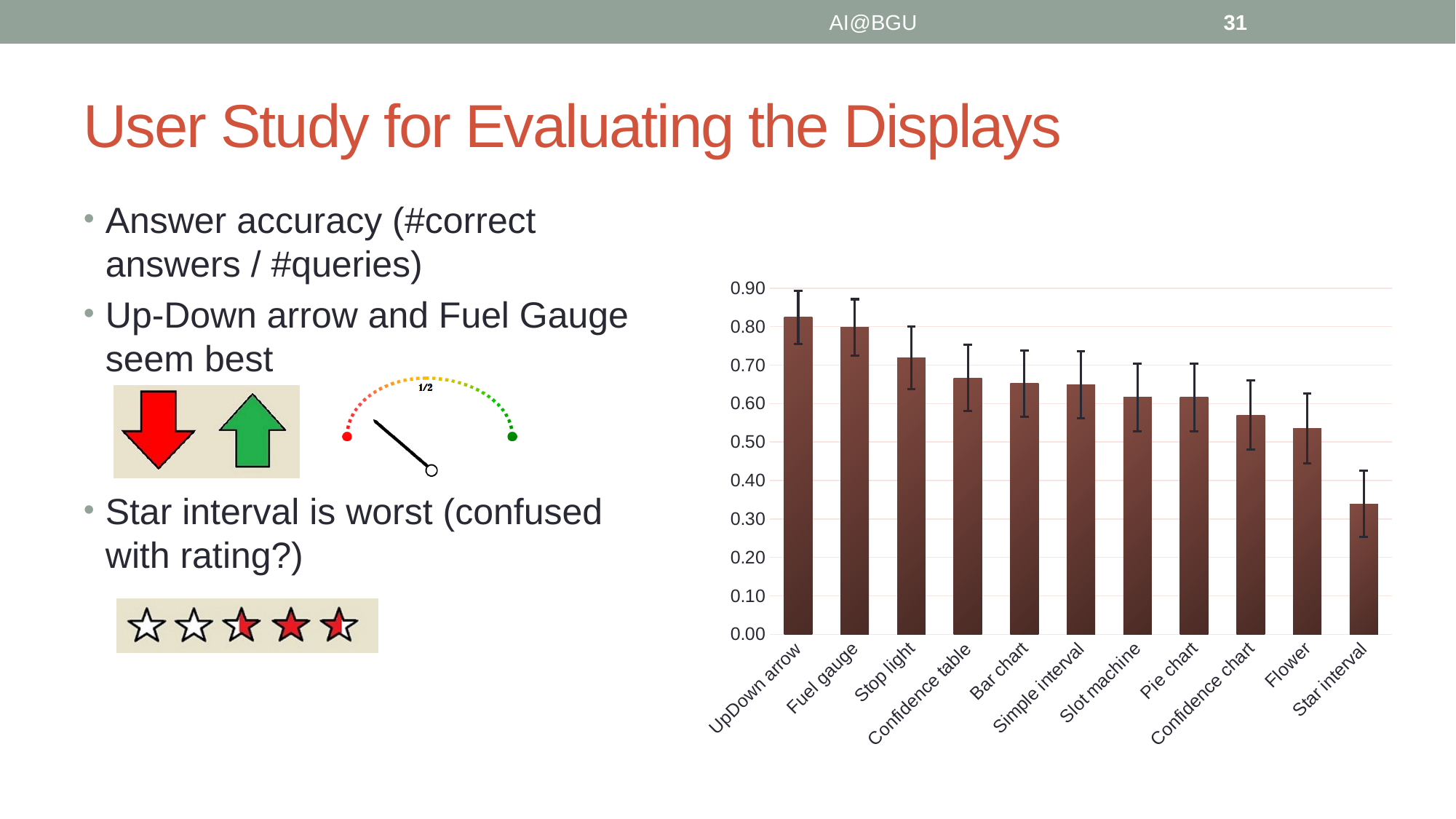
What kind of chart is shown on the slide? bar chart Is the value for Confidence chart greater or less than 0.60? less Which has the larger value, Pie chart or Star interval? Pie chart How many display types (categories) are plotted on the chart? 11 Do the bar values rise or fall from left to right along the x axis? fall Which display type has the highest bar on the chart? UpDown arrow Which has the larger value, Stop light or Flower? Stop light Which display type has the lowest bar on the chart? Star interval Is the value for Star interval greater or less than 0.40? less Is the value for Stop light greater or less than 0.70? greater Does the chart show error bars on the bars? yes